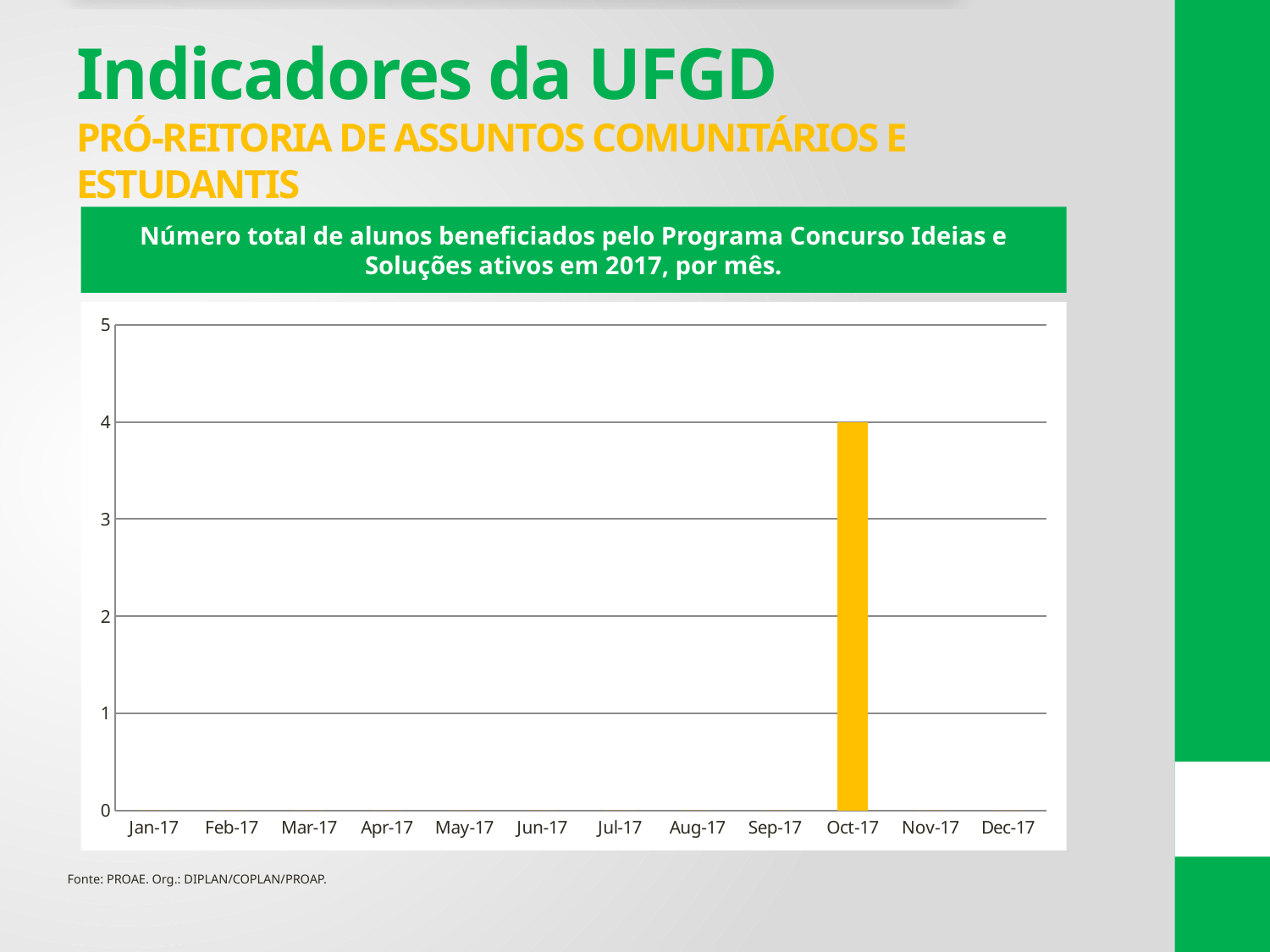
What is the value for Oct-17? 4 What is the value for Jan-17? 0 Which is larger, the value for Oct-17 or the value for Sep-17? Oct-17 What is the highest value shown on the y axis? 5 Is the value for Oct-17 greater or less than 3? greater What colour is the bar in the chart? yellow How many months are shown along the x axis of the chart? 12 What kind of chart is shown on the slide? bar chart Is the value for Oct-17 greater or less than 5? less How many months show a visible bar in the chart? 1 What is the title of the chart? Número total de alunos beneficiados pelo Programa Concurso Ideias e Soluções ativos em 2017, por mês. Which month has the highest value in the chart? Oct-17